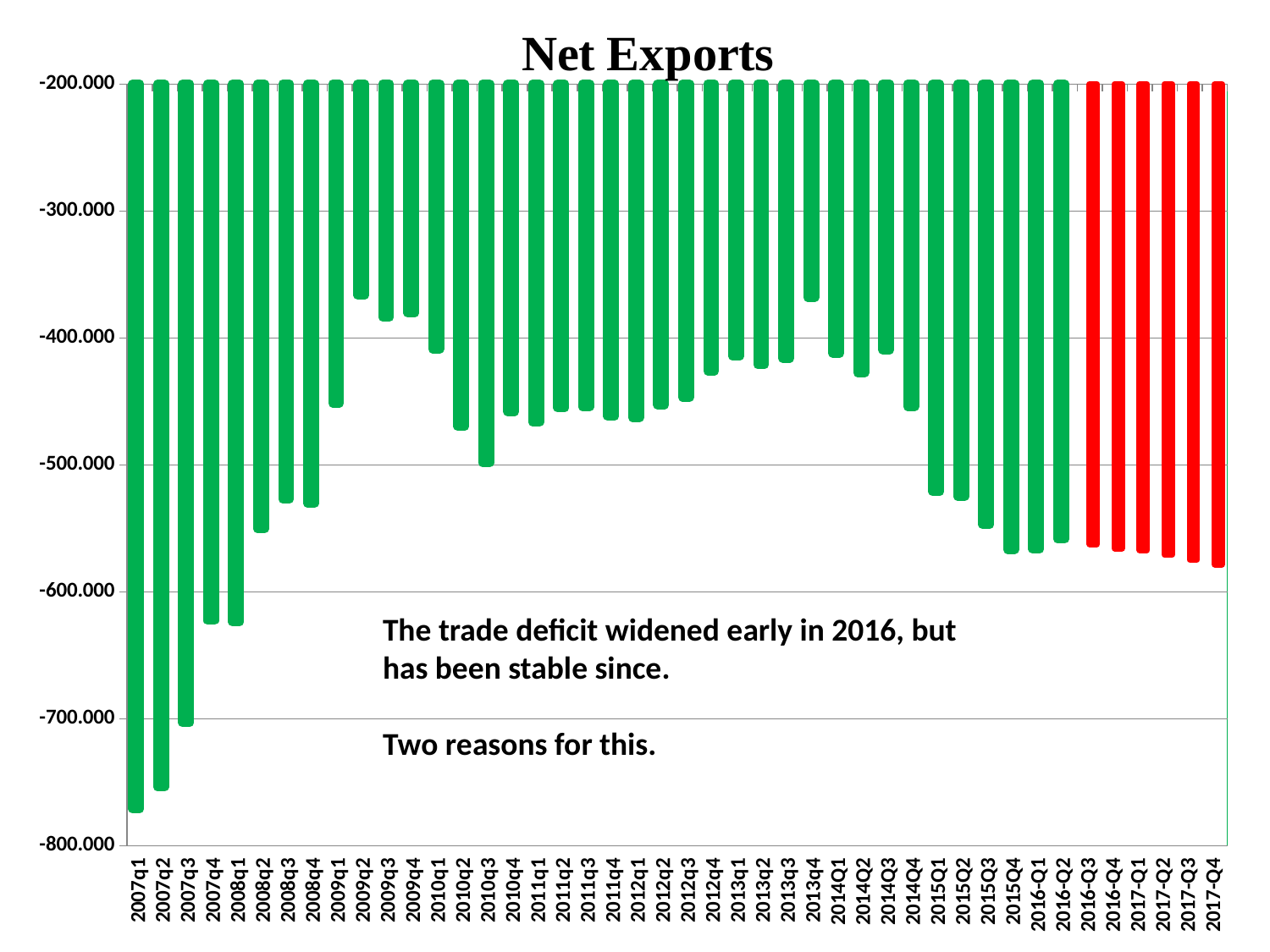
Is the value for 2008q1 greater or less than -600.000? less How many quarters (bars) are plotted in the Net Exports chart? 44 Which quarter has the lowest (most negative) net exports value? 2007q1 Do the values rise or fall from 2014Q1 to 2017-Q4? fall Is the value for 2017-Q4 greater or less than -600.000? greater Is the value for 2015Q1 greater or less than -500.000? less What is the title of the chart? Net Exports Which is larger, the value for 2007q1 or the value for 2017-Q4? 2017-Q4 How many bars are coloured red in the chart? 6 Which is larger, the value for 2009q2 or the value for 2010q3? 2009q2 What kind of chart is shown on the slide? bar chart